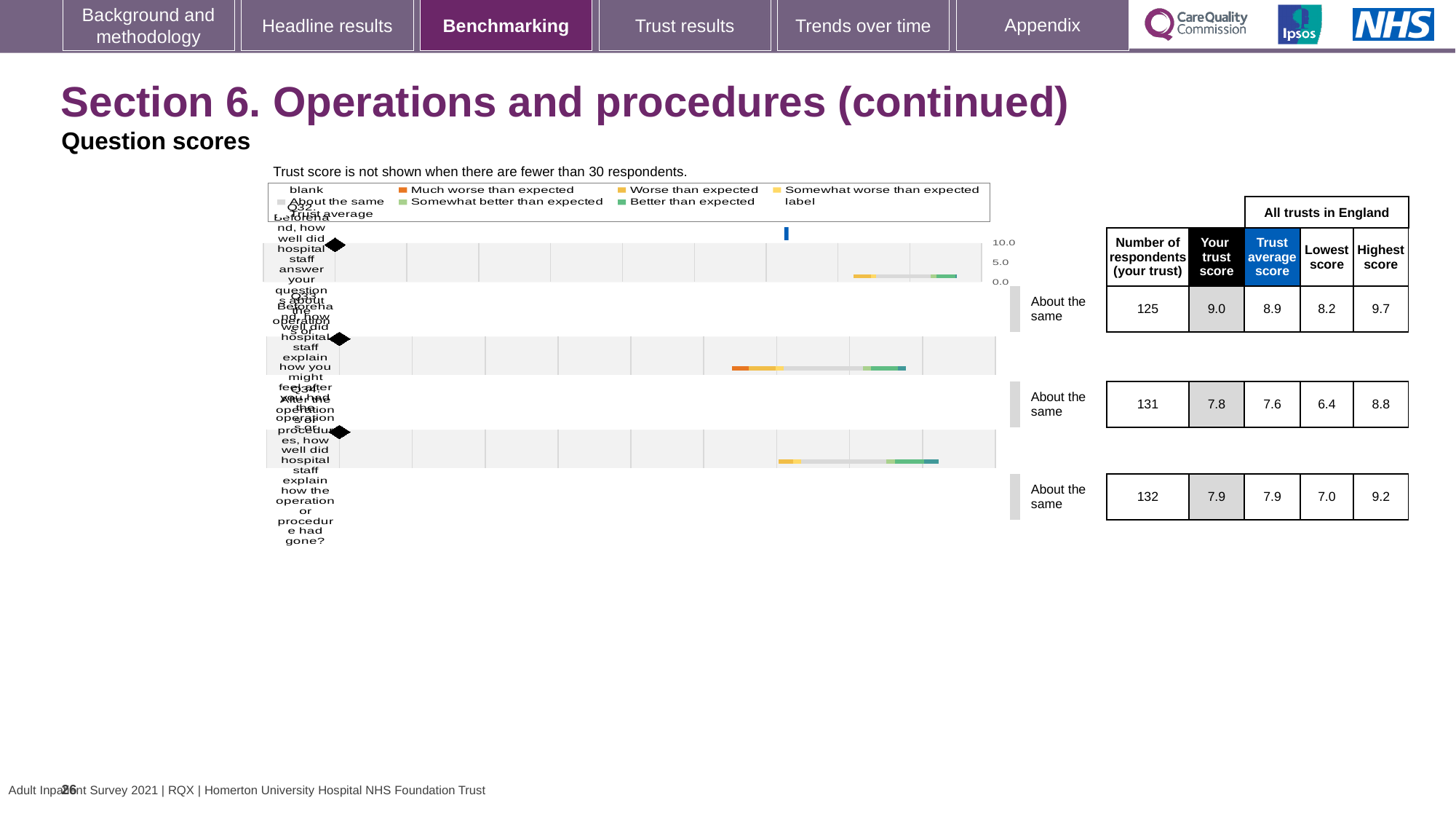
In the table, what is 'Your trust score' for the top row? 9.0 Which row has the highest number of respondents? the bottom row (132) How many question rows are shown in the benchmarking chart and table? 3 What kind of chart is used to show the benchmarking results on this slide? bar chart In the table, what is the lowest score for the second row? 6.4 In the table, what is the number of respondents for the top row? 125 In the second row, which is larger: 'Your trust score' or the trust average score? Your trust score (7.8) What benchmark category is shown next to each of the three rows? About the same What colour does the legend use for 'Much worse than expected'? orange In the table, what is the highest score for the bottom row? 9.2 In the table, what is the trust average score for the second row? 7.6 What is the difference between the highest score and the lowest score in the top row? 1.5